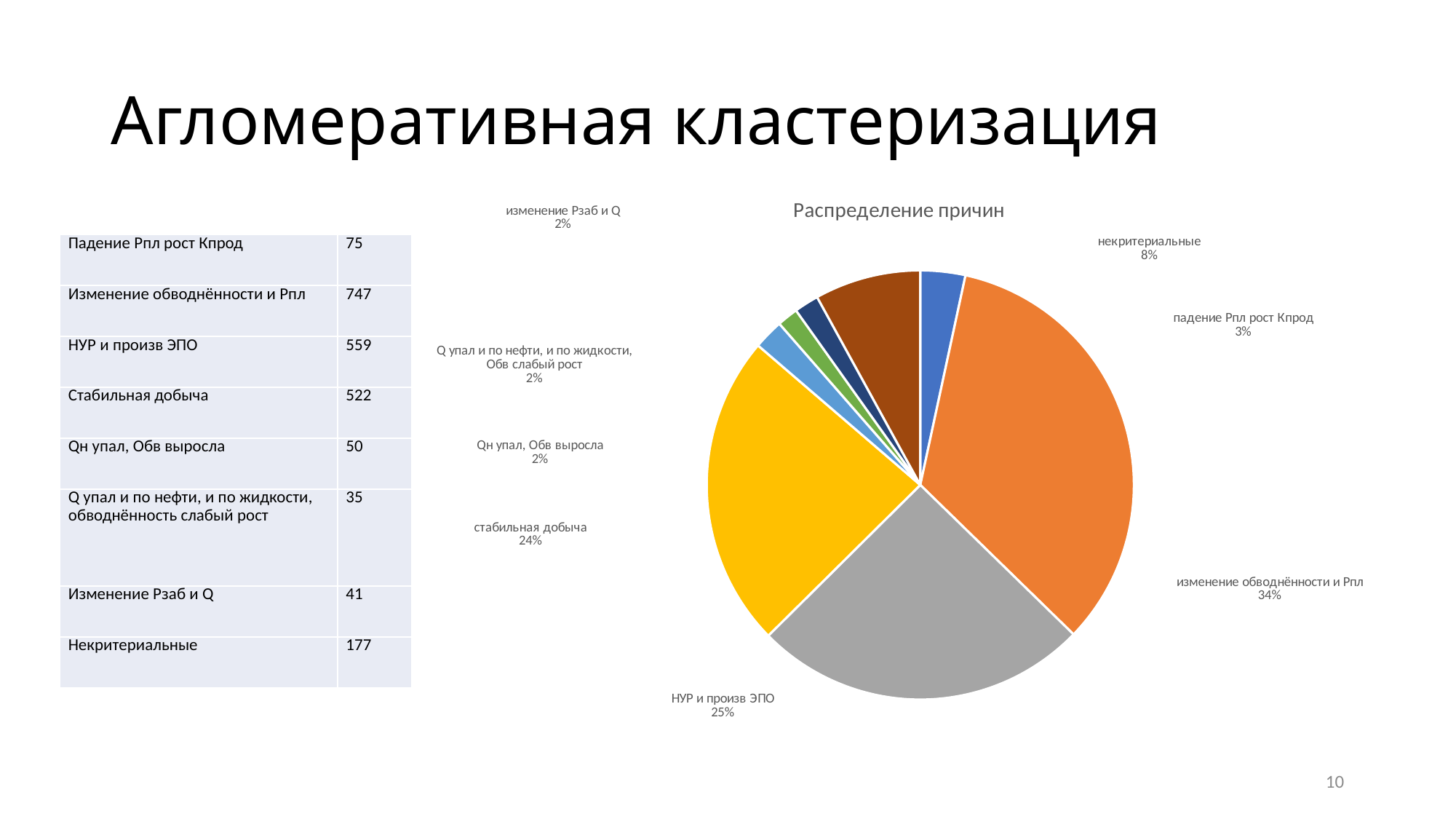
Which category has the largest slice of the pie? изменение обводнённости и Рпл What share of the pie does "изменение Рзаб и Q" have? 2% What is the title of the pie chart? Распределение причин Which slice is larger: "изменение обводнённости и Рпл" or "стабильная добыча"? изменение обводнённости и Рпл How many slices does the pie chart have? 8 What share of the pie does "стабильная добыча" have? 24% What kind of chart is shown on the slide? pie chart What share of the pie does "некритериальные" have? 8% What is the difference in percentage points between "изменение обводнённости и Рпл" and "НУР и произв ЭПО"? 9